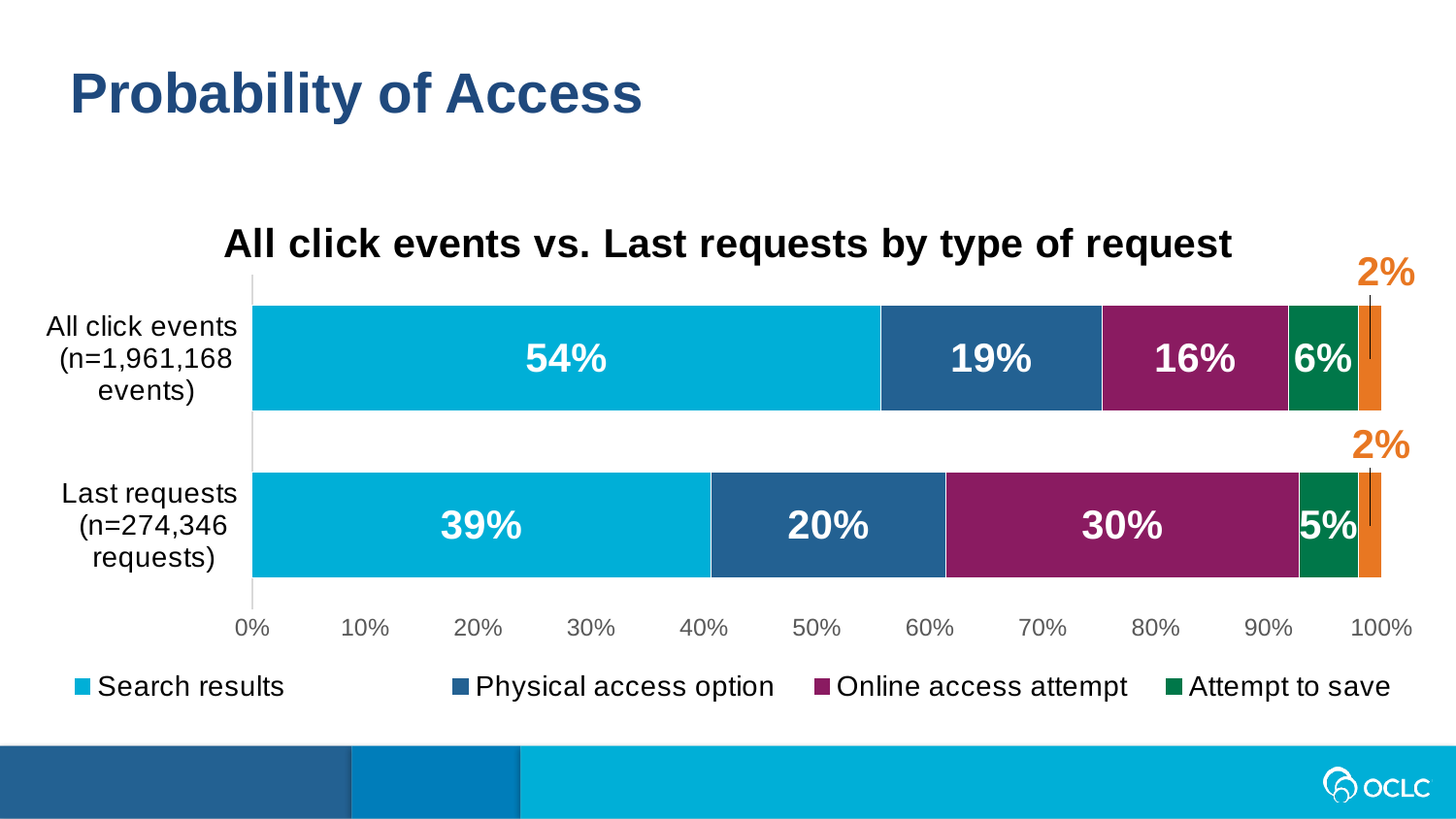
What is the difference between the Search results values for All click events and Last requests? 15% What kind of chart is shown on the slide? Stacked bar chart Which category has the higher Search results value, All click events or Last requests? All click events What is the Physical access option value for Last requests? 20% How many categories (bars) are plotted in the chart? 2 What is the difference between the Online access attempt values for Last requests and All click events? 14% What is the Attempt to save value for All click events? 6% What is the Search results value for All click events? 54% How many series does the legend list? 4 Which segment is the largest in the Last requests bar? Search results What is the chart's title? All click events vs. Last requests by type of request What is the Online access attempt value for Last requests? 30%